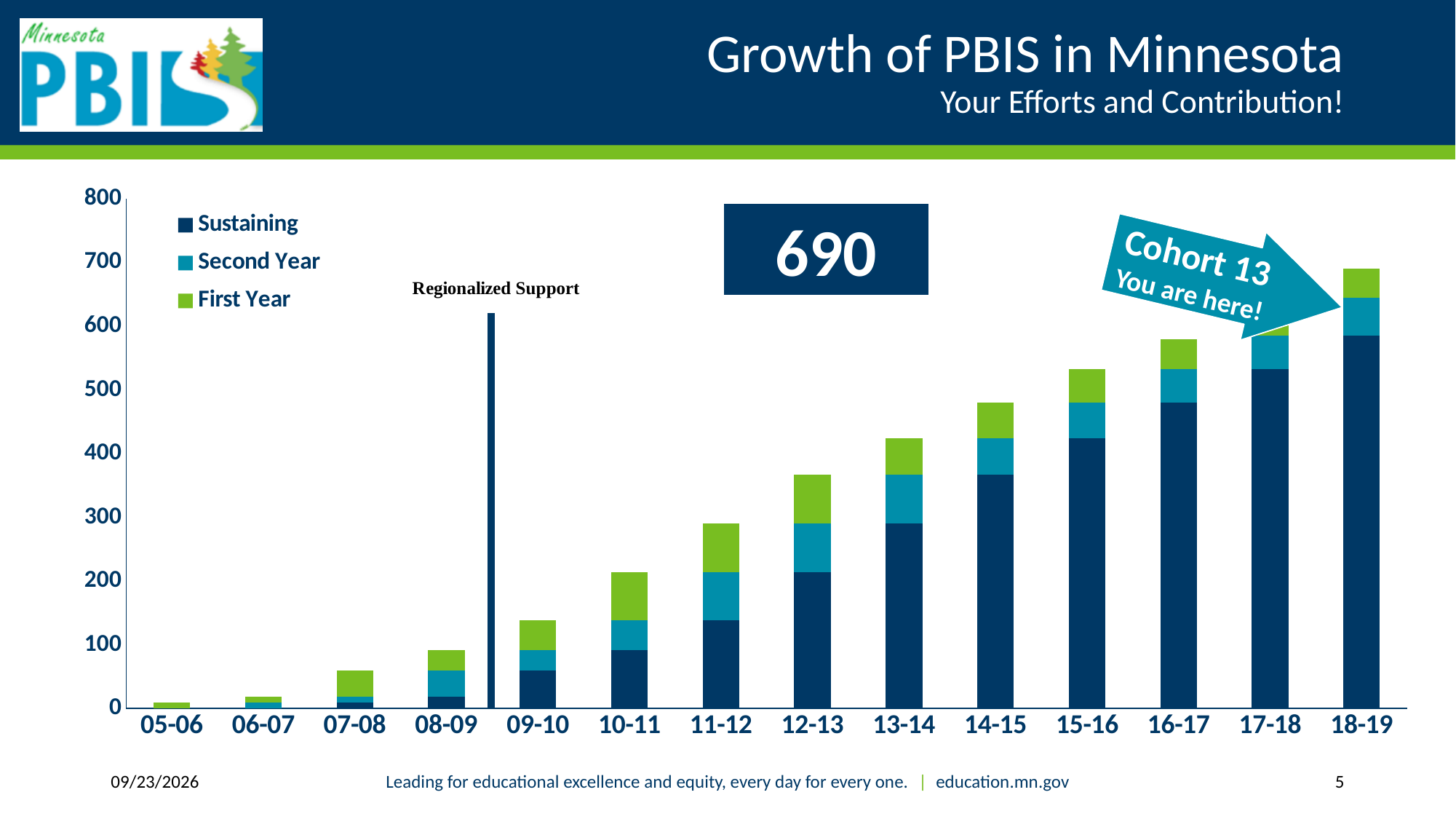
Which school year has the tallest stacked bar? 18-19 Is the total bar height for 05-06 greater or less than 100? less Which school year has the shortest stacked bar? 05-06 Do the stacked bar totals rise or fall from 05-06 to 18-19? Rise How many series does the chart legend list? 3 Which has a taller stacked bar, 16-17 or 13-14? 16-17 How many school-year categories are shown on the x axis? 14 Is the total bar height for 17-18 greater or less than 500? greater What kind of chart is shown on the slide? Bar chart Is the total bar height for 18-19 greater or less than 600? greater What label is attached to the vertical line between 08-09 and 09-10? Regionalized Support